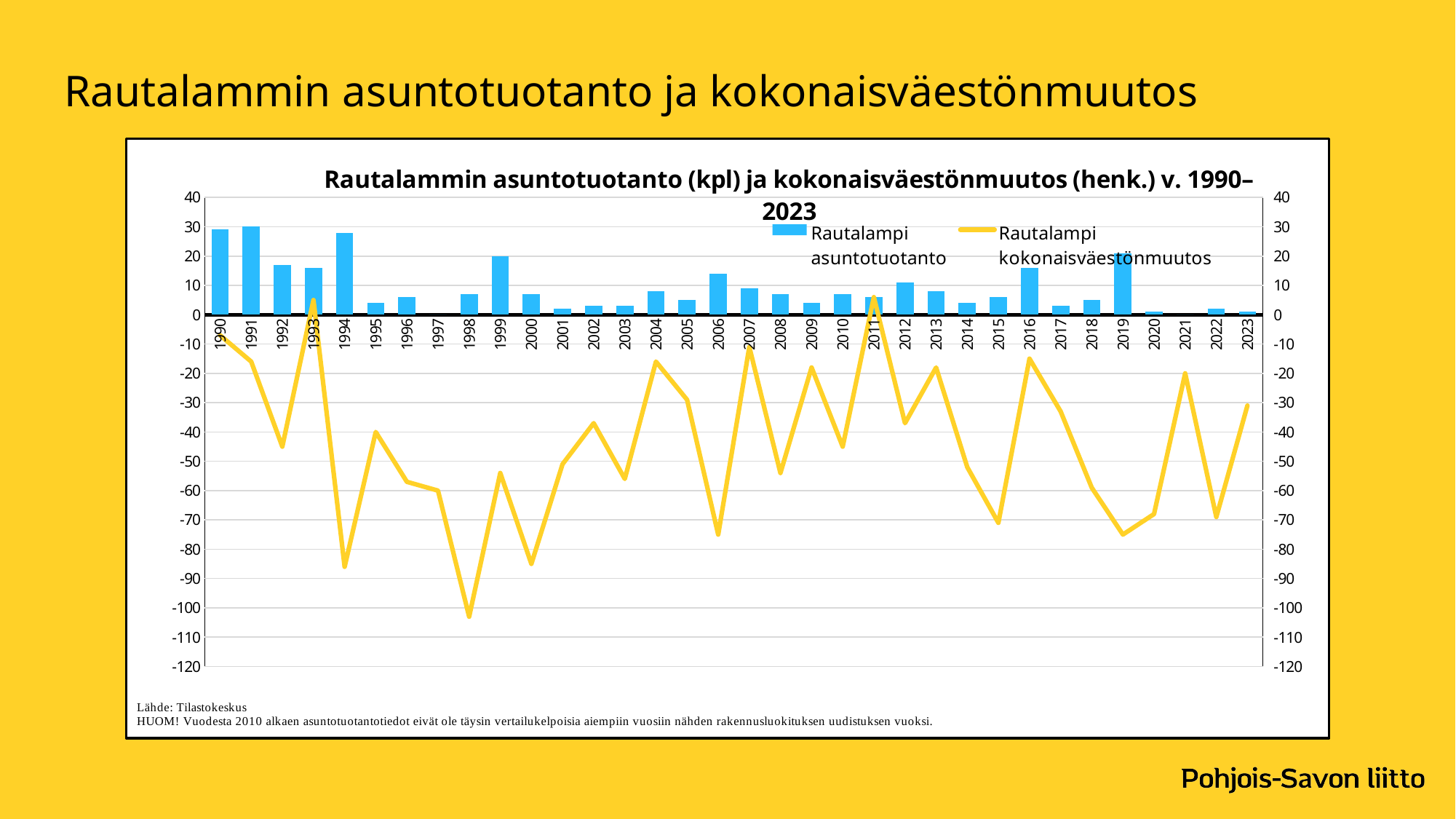
Is the Rautalampi kokonaisväestönmuutos value for 2022 greater or less than -60? less Is the Rautalampi kokonaisväestönmuutos value for 2016 greater or less than -20? greater How many series does the legend list? 2 Which year has the larger Rautalampi kokonaisväestönmuutos value, 1998 or 2011? 2011 Is the Rautalampi kokonaisväestönmuutos value for 1998 greater or less than -100? less How many years are shown on the x axis? 34 Which year has the lowest value for Rautalampi kokonaisväestönmuutos? 1998 Which year has the larger Rautalampi asuntotuotanto value, 1994 or 1995? 1994 What kind of chart is shown on the slide? A combined bar and line chart What source is cited below the chart? Tilastokeskus